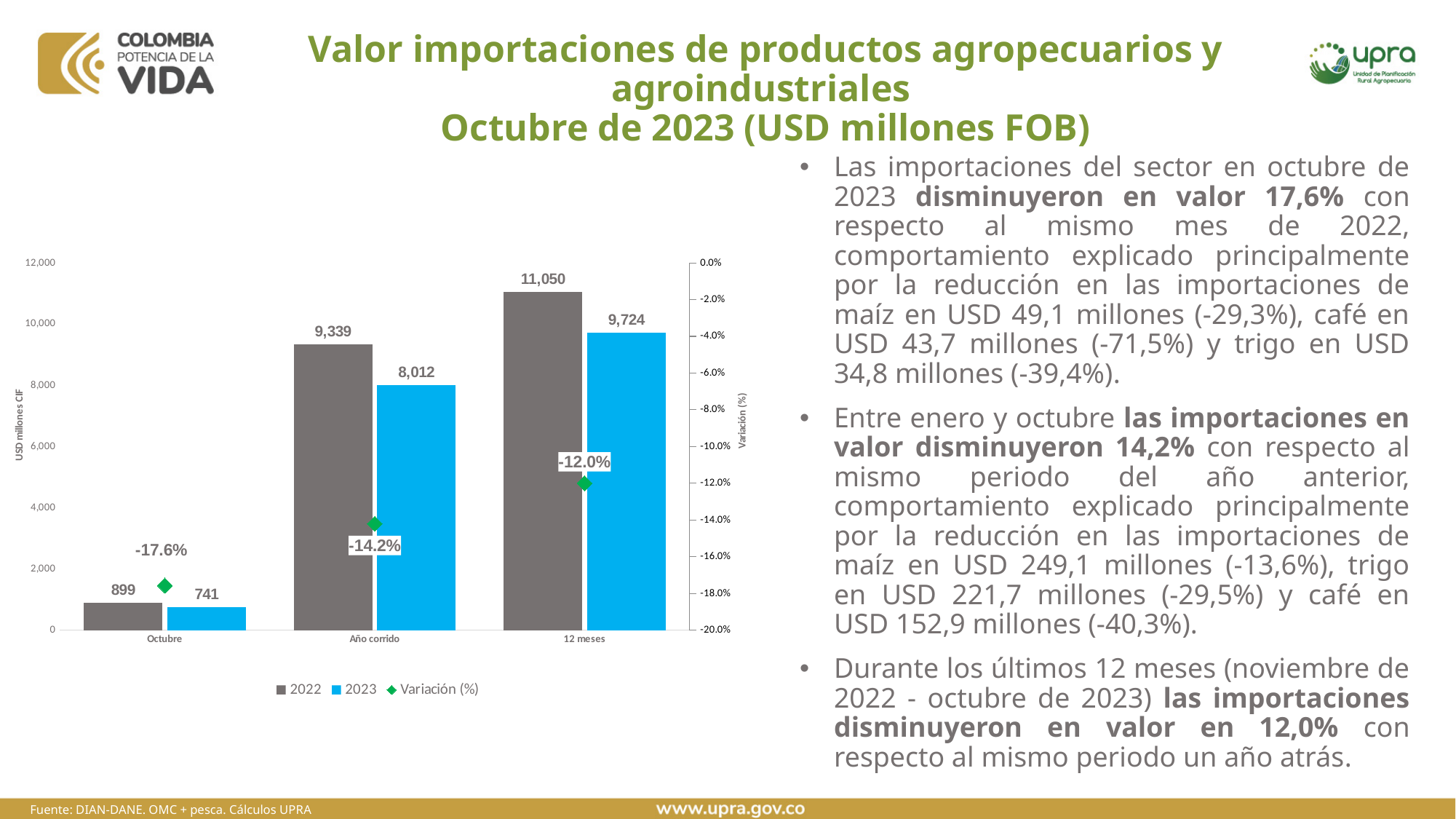
How many series does the legend list? 3 What kind of chart is used to show the 2022 and 2023 values? bar chart What is the 2022 value for Octubre? 899 What is the 2023 value for Año corrido? 8,012 Is the 2023 value for Año corrido greater or less than 10,000? less How many categories are shown on the x axis? 3 Which is larger, the 2022 value for Año corrido or the 2023 value for 12 meses? 2023 value for 12 meses What is the label of the left vertical axis? USD millones CIF Which category has the lowest 2023 value? Octubre What is the Variación (%) for 12 meses? -12.0% Which category has the highest 2022 value? 12 meses What is the difference between the 2022 and 2023 values for 12 meses? 1,326